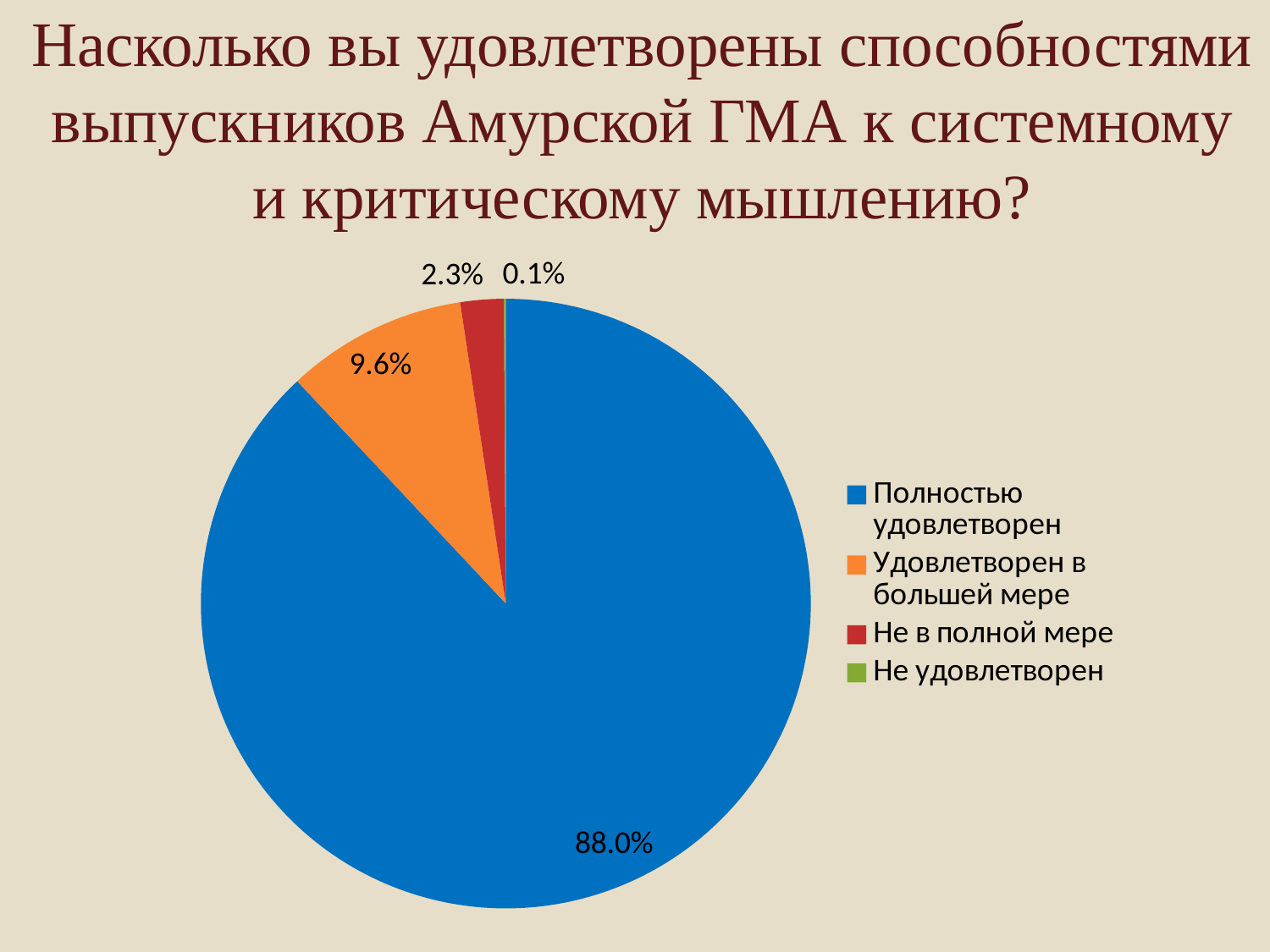
What share of respondents answered "Не в полной мере"? 2.3% Which is larger: the share for "Удовлетворен в большей мере" or for "Не в полной мере"? Удовлетворен в большей мере What is the combined share of "Не в полной мере" and "Не удовлетворен"? 2.4% What share of respondents answered "Удовлетворен в большей мере"? 9.6% What is the difference between the shares for "Полностью удовлетворен" and "Удовлетворен в большей мере"? 78.4% What share of respondents answered "Не удовлетворен"? 0.1% Which category has the largest slice of the pie? Полностью удовлетворен What colour is the slice for "Не в полной мере"? Red What kind of chart is shown on the slide? Pie chart What share of respondents answered "Полностью удовлетворен"? 88.0% How many categories does the pie chart show? 4 Which category has the smallest slice of the pie? Не удовлетворен